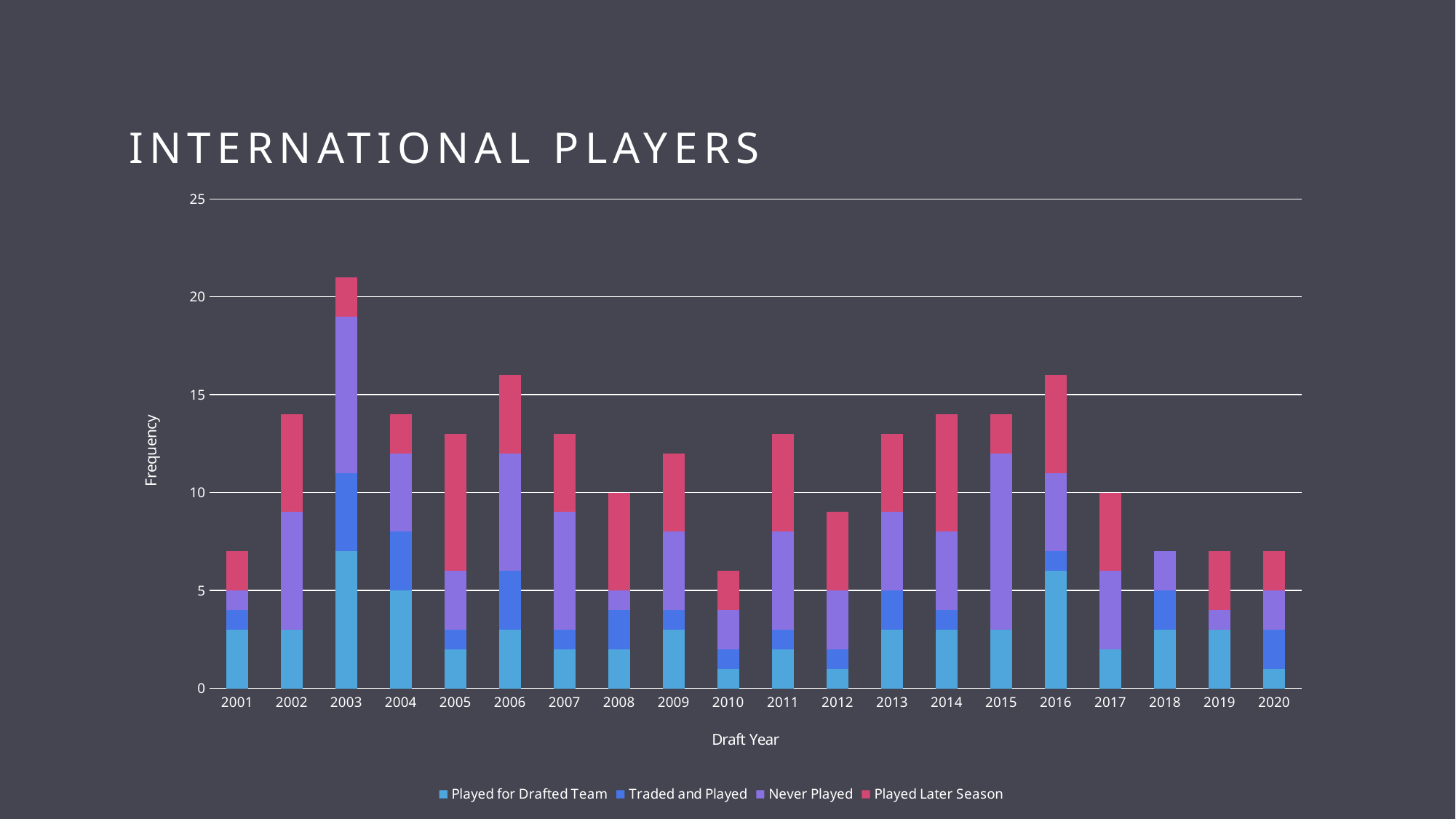
Which draft year has the highest total frequency? 2003 Is the total value for 2016 greater or less than 15? greater Is the total value for 2010 greater or less than 10? less How many series does the legend list? 4 Do the total values rise or fall from 2016 to 2018? fall What is the title of the chart? INTERNATIONAL PLAYERS Which draft year has a larger total, 2003 or 2016? 2003 Which draft year has a larger total, 2010 or 2012? 2012 How many draft years are shown on the x axis? 20 Is the total value for 2003 greater or less than 20? greater Which draft year has the lowest total frequency? 2010 What kind of chart is shown on the slide? Stacked bar chart